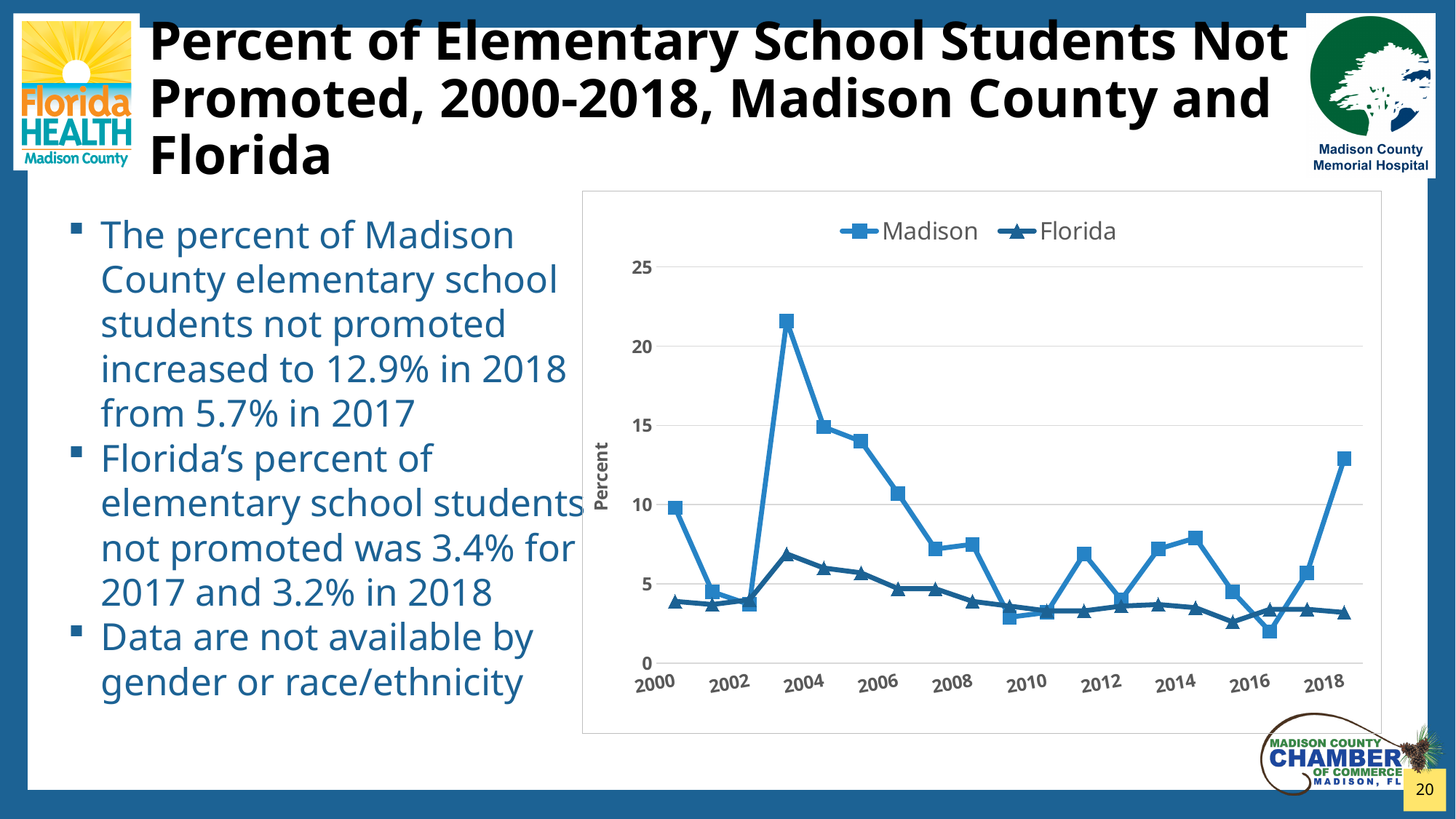
In 2004, which series has the larger value, Madison or Florida? Madison What kind of chart is shown on the slide? line chart How many series does the chart legend list? 2 By how many percentage points did the Madison County value increase from 2017 to 2018? 7.2 Does the Madison series rise or fall between 2004 and 2009? fall What was Florida's percent of elementary school students not promoted in 2018? 3.2% What was the percent of Madison County elementary school students not promoted in 2018? 12.9% Is the Madison value for 2016 greater or less than 5? less In which year does the Madison series reach its highest value? 2003 Is the Florida value for 2004 greater or less than 5? greater What are the two series named in the chart legend? Madison and Florida Is the Madison value for 2004 greater or less than 20? less